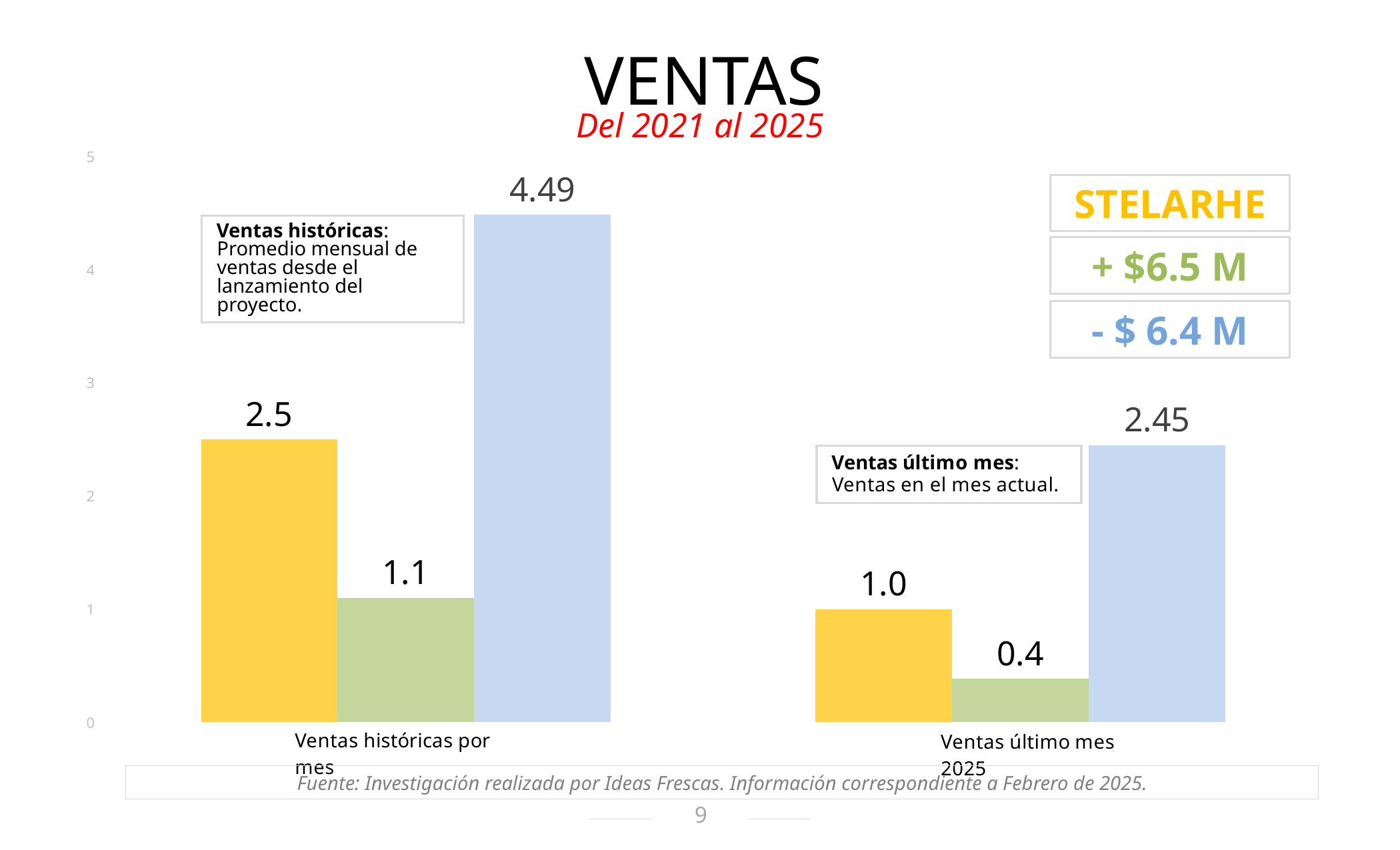
What is the difference between the blue bar (4.49) and the yellow bar (2.5) for 'Ventas históricas por mes'? 1.99 What is the value of the STELARHE (yellow) bar for 'Ventas históricas por mes'? 2.5 Which series has the lowest bar in the 'Ventas último mes 2025' group? + $6.5 M Which is larger: the blue bar for 'Ventas último mes 2025' or the yellow bar for 'Ventas históricas por mes'? The yellow bar for 'Ventas históricas por mes' (2.5) What kind of chart is shown on the slide? Bar chart What is the value of the blue '- $ 6.4 M' bar for 'Ventas históricas por mes'? 4.49 How many categories are shown on the x axis of the chart? 2 How many series does the legend list? 3 What is the value of the STELARHE (yellow) bar for 'Ventas último mes 2025'? 1.0 What is the value of the green '+ $6.5 M' bar for 'Ventas último mes 2025'? 0.4 Which series has the highest bar in the 'Ventas históricas por mes' group? - $ 6.4 M What is the difference between the STELARHE bar for 'Ventas históricas por mes' and the STELARHE bar for 'Ventas último mes 2025'? 1.5